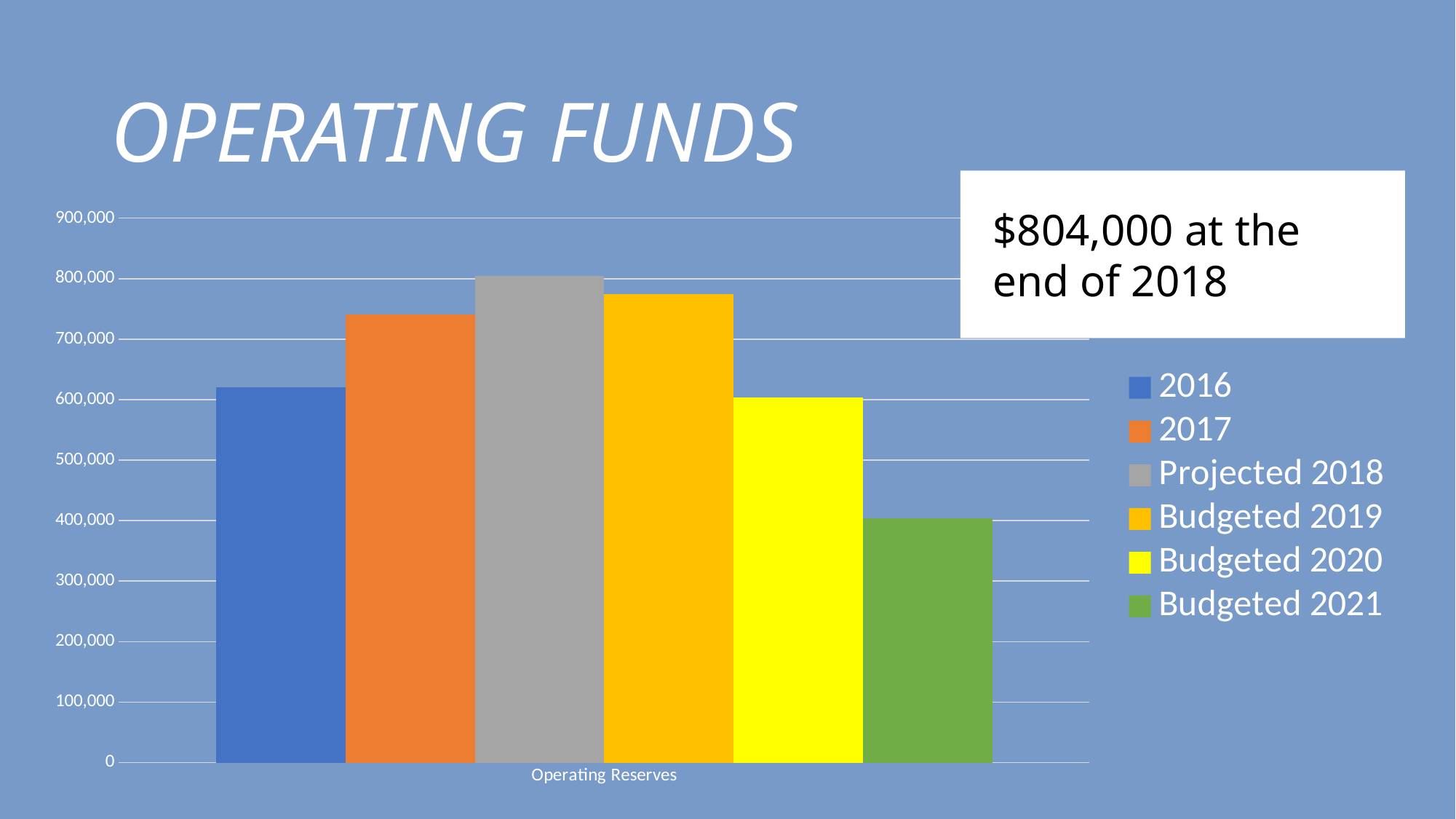
How many categories are shown on the x axis? 1 What kind of chart is shown on the slide? bar chart Which series has the lowest value for Operating Reserves? Budgeted 2021 Which is larger, the value for 2017 or the value for Budgeted 2019? Budgeted 2019 Is the value for 2016 greater or less than 700,000? less What is the category label shown on the x axis? Operating Reserves Is the value for 2017 greater or less than 700,000? greater Is the value for Budgeted 2021 greater or less than 500,000? less Which is larger, the value for 2016 or the value for 2017? 2017 How many series does the legend list? 6 Which series has the highest value for Operating Reserves? Projected 2018